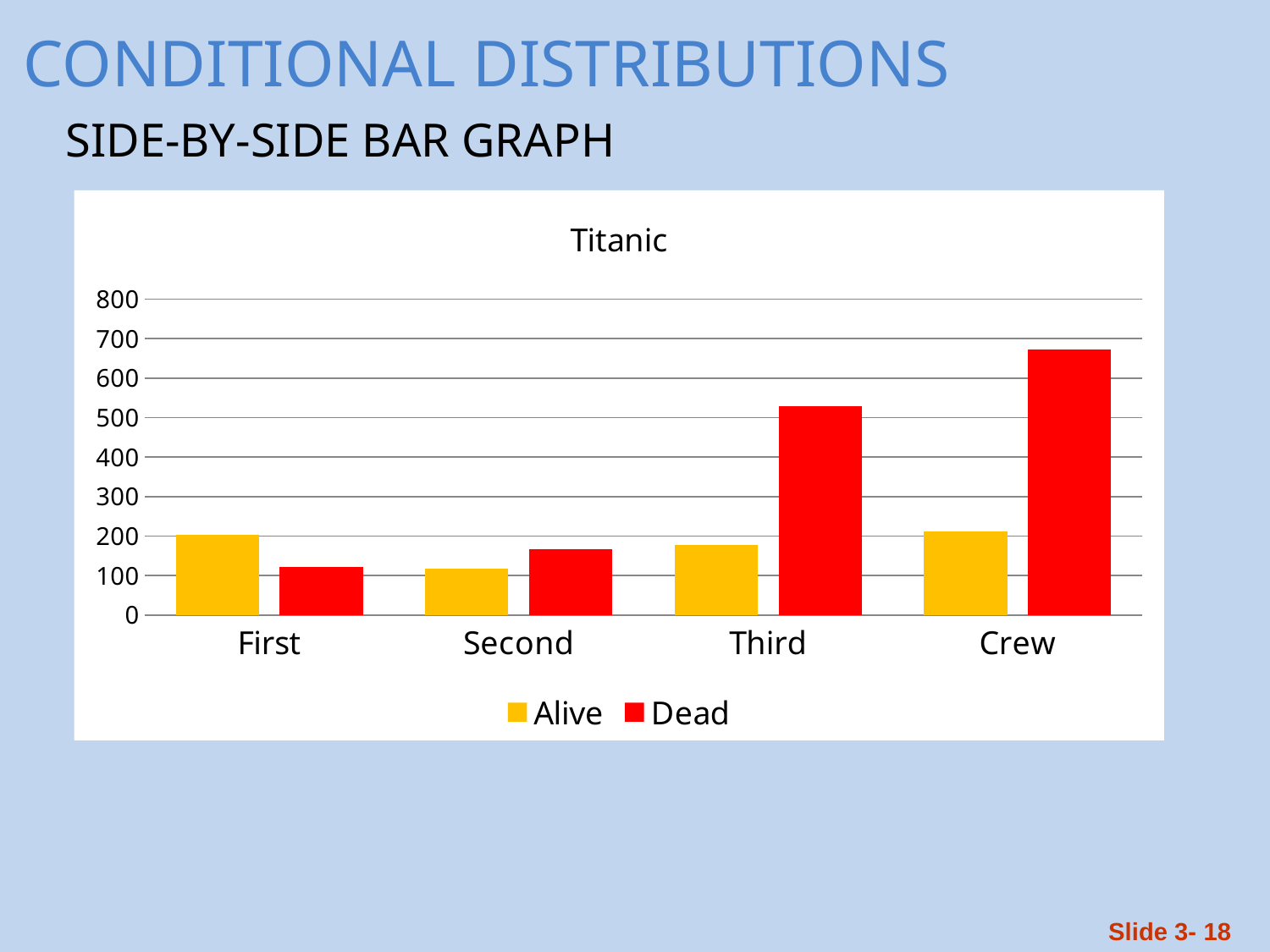
Which category has the highest Dead value? Crew How many series does the legend list? 2 For the Third category, which is larger, Alive or Dead? Dead For the First category, which is larger, Alive or Dead? Alive Is the Dead value for Crew greater or less than 600? greater Which category has the lowest Dead value? First How many categories are shown on the x axis? 4 Which category has the lowest Alive value? Second What kind of chart is shown on the slide? bar chart Is the Alive value for Second greater or less than 200? less What is the title of the chart? Titanic Is the Dead value for Third greater or less than 500? greater